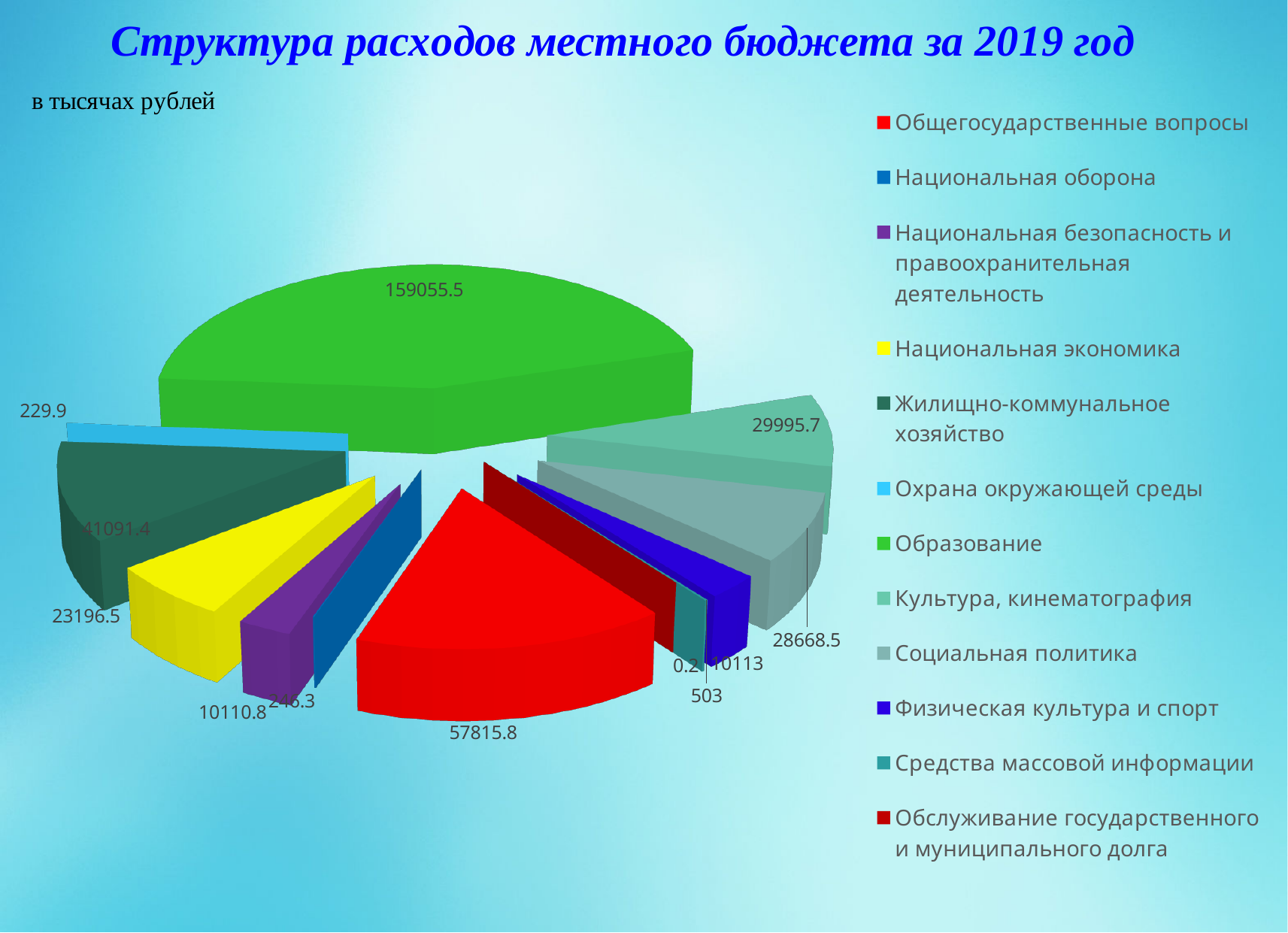
What is the difference between the values for Образование and Общегосударственные вопросы? 101239.7 What kind of chart is shown on the slide? pie chart Which is larger, Культура, кинематография or Социальная политика? Культура, кинематография What is the value for Социальная политика? 28668.5 How many categories does the legend of the pie chart list? 12 What is the value for Общегосударственные вопросы? 57815.8 What is the value for Образование? 159055.5 In what units are the values on the chart given, according to the slide? в тысячах рублей What is the value for Средства массовой информации? 503 Which category has the largest slice of the pie? Образование What is the value for Жилищно-коммунальное хозяйство? 41091.4 What is the value for Национальная экономика? 23196.5